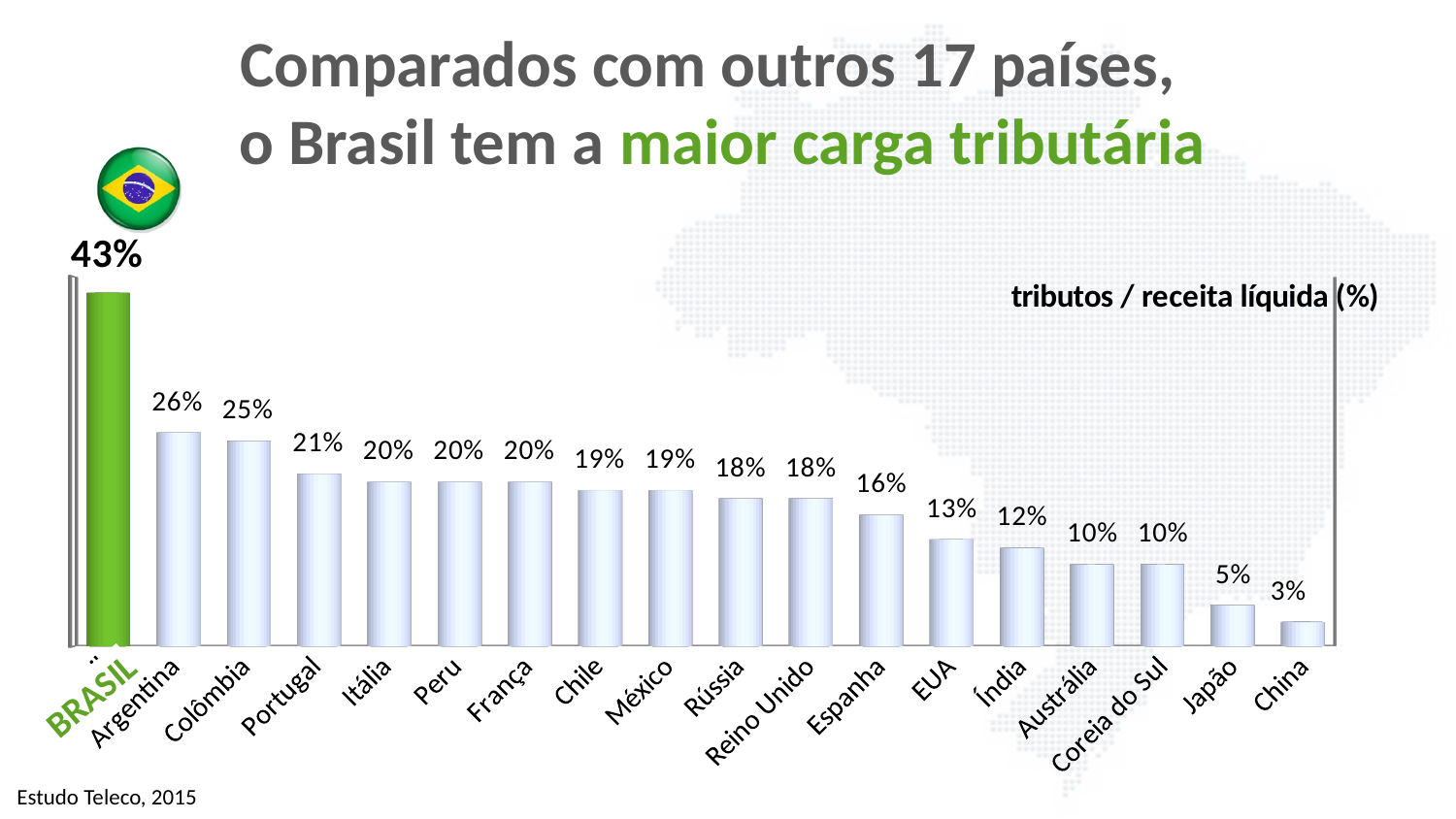
Which is larger, the value for Portugal or the value for Chile? Portugal What is the value for Espanha? 16% What is the value for Argentina? 26% What is the value for Brasil? 43% What is the difference between the values for Brasil and Argentina? 17% Which country has the lowest value? China What kind of chart is shown on the slide? Bar chart What is the label shown above the chart describing the measure plotted? tributos / receita líquida (%) Which country has the highest value? Brasil What is the difference between the values for EUA and Índia? 1% What is the value for Japão? 5% How many countries are shown in the chart? 18